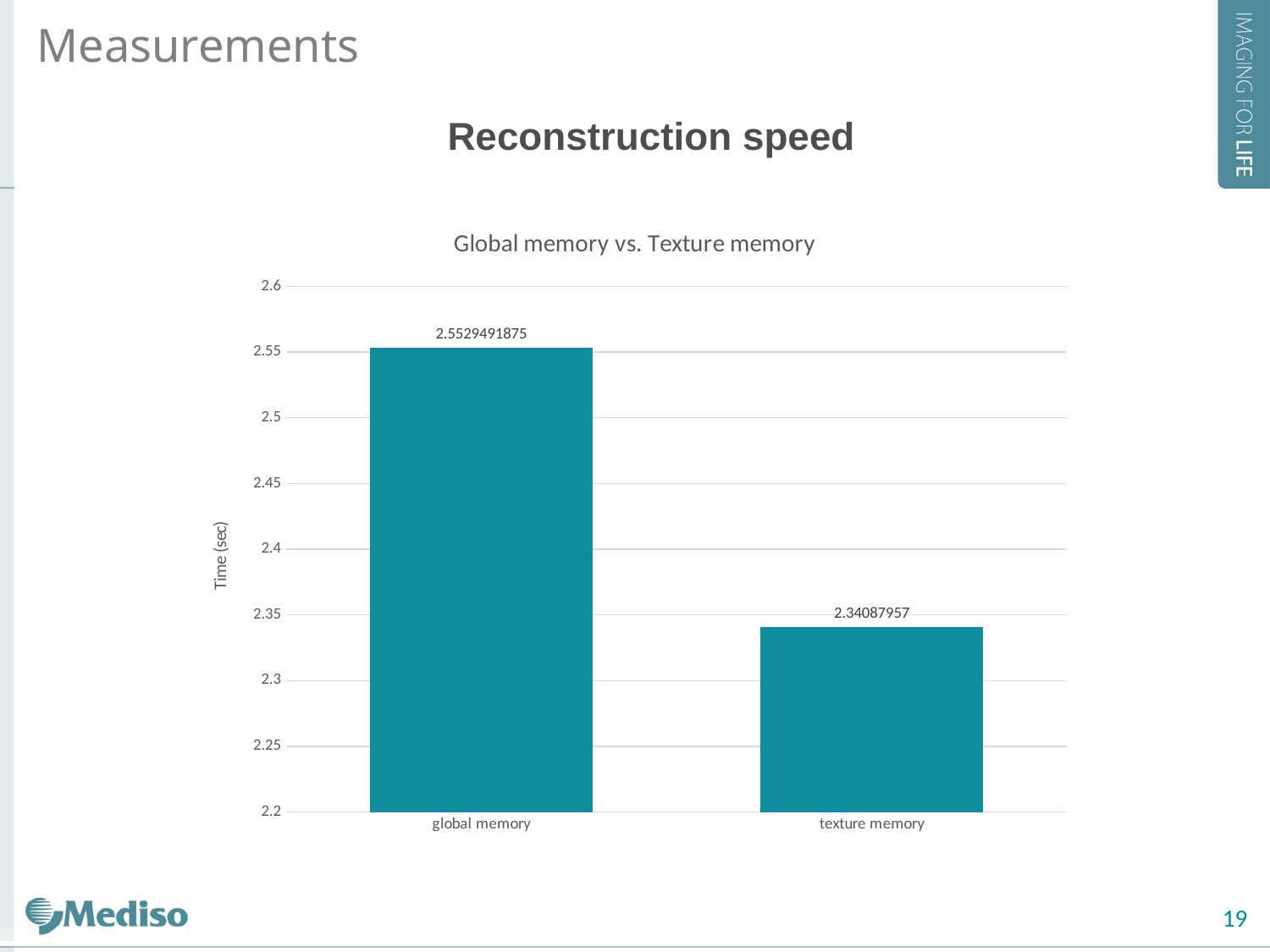
What kind of chart is shown on the slide? bar chart Is the value for global memory greater or less than 2.5? greater What is the label of the vertical axis? Time (sec) What is the difference between the global memory and texture memory values? 0.2120696175 What is the value for texture memory? 2.34087957 What is the value for global memory? 2.5529491875 Is the value for texture memory greater or less than 2.35? less What is the title of the chart? Global memory vs. Texture memory Which is larger, the value for global memory or the value for texture memory? global memory Which category has the lowest value? texture memory Which category has the highest value? global memory How many categories are shown in the chart? 2